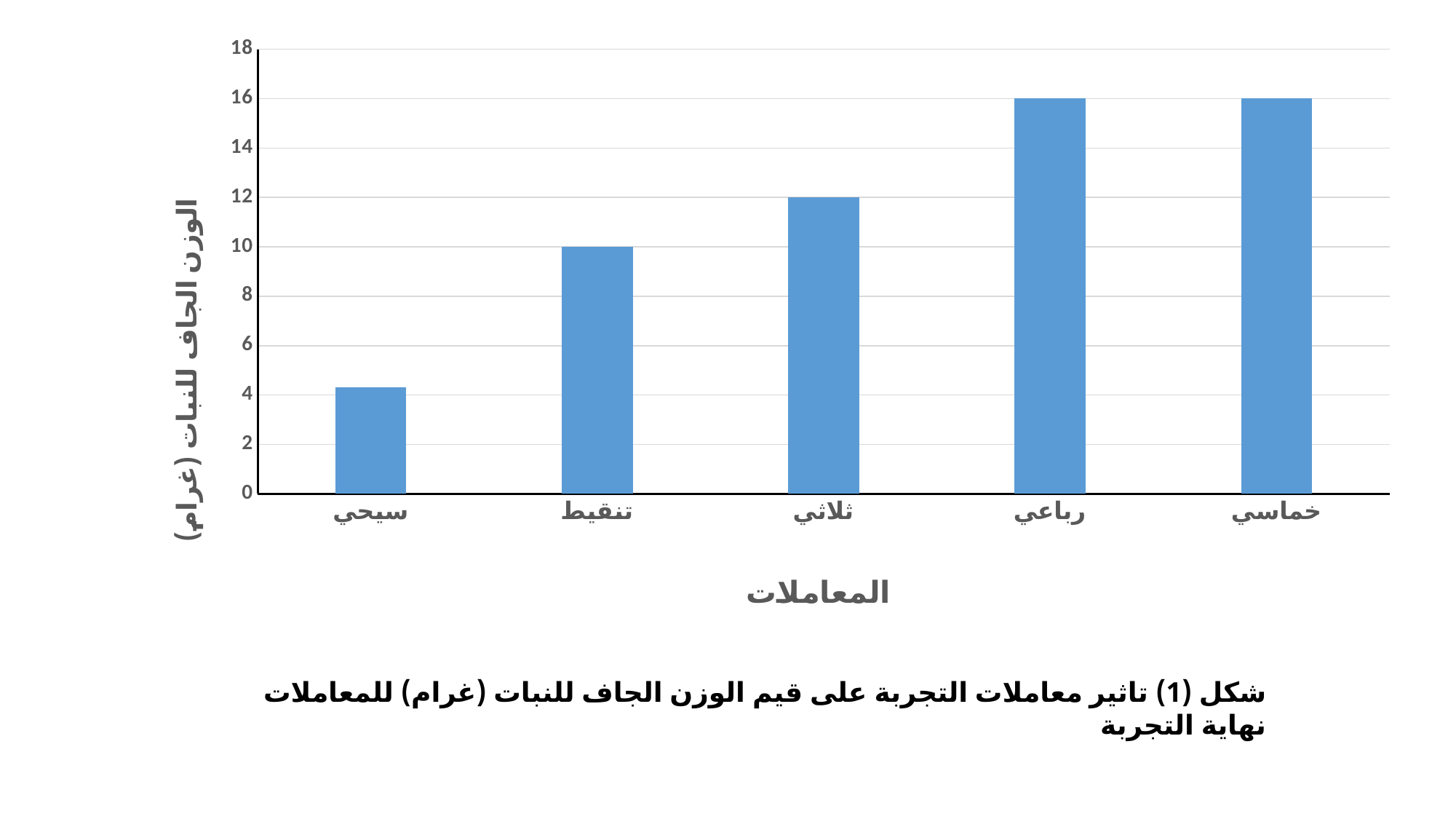
What is the value for تنقيط? 10 How many categories are shown on the x axis? 5 Is the value for سيحي greater or less than 6? less What is the value for رباعي? 16 What is the difference between the values for ثلاثي and تنقيط? 2 What is the difference between the values for رباعي and تنقيط? 6 What is the title of the y axis? الوزن الجاف للنبات (غرام) What kind of chart is shown on the slide? bar chart What is the value for ثلاثي? 12 What is the value for خماسي? 16 Which is larger, the value for تنقيط or the value for ثلاثي? ثلاثي Which category has the lowest value? سيحي